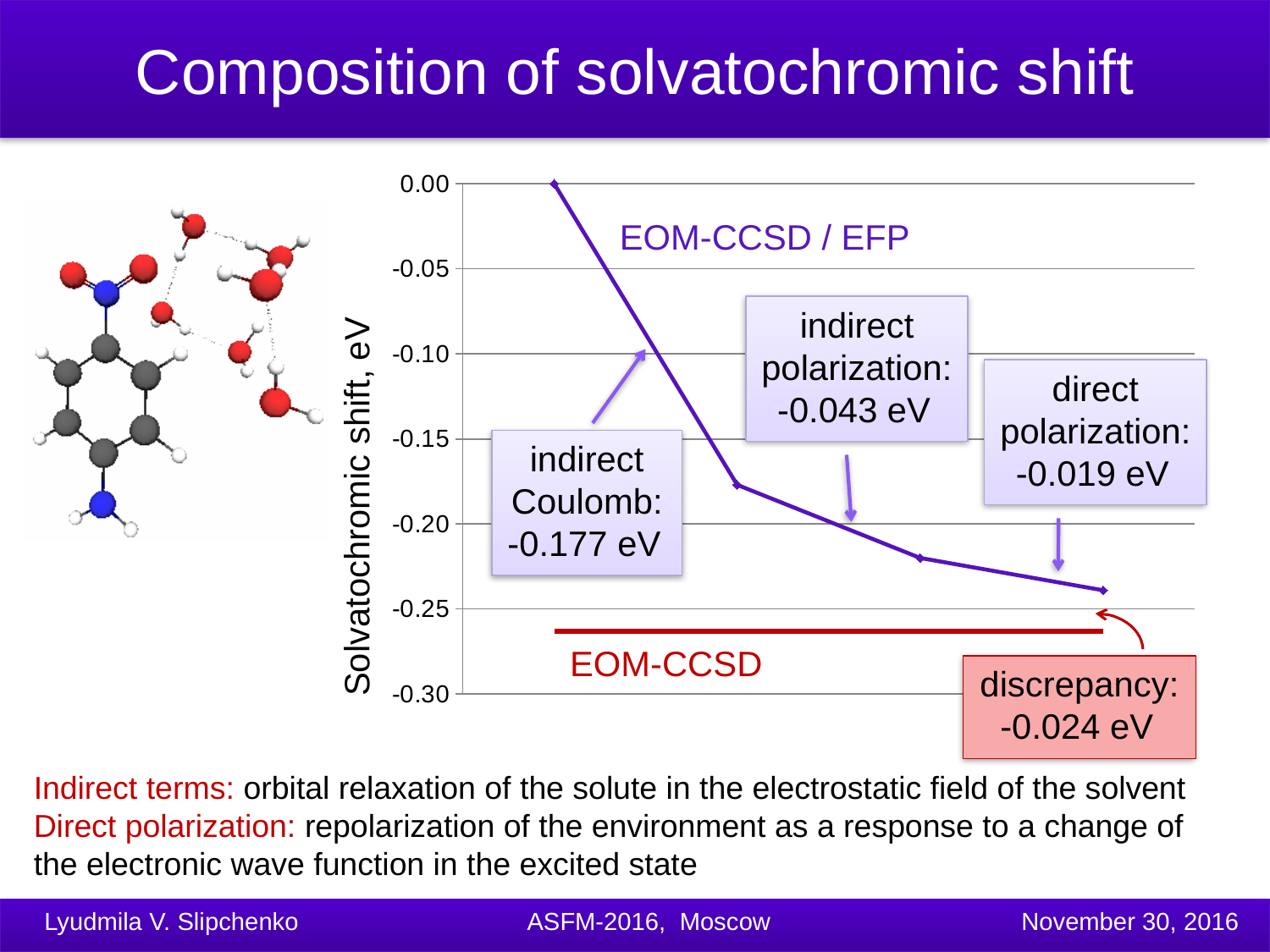
What is the label of the y axis of the chart? Solvatochromic shift, eV By how much does the magnitude of the indirect polarization contribution exceed that of the direct polarization contribution? 0.024 eV What kind of chart is shown on the slide? line chart What is the value of the direct polarization contribution shown on the chart? -0.019 eV Does the EOM-CCSD/EFP line rise or fall from left to right? fall What is the sum of the indirect Coulomb, indirect polarization and direct polarization contributions? -0.239 eV What is the discrepancy between EOM-CCSD/EFP and EOM-CCSD shown on the chart? -0.024 eV Is the value of the red EOM-CCSD line greater or less than -0.25? less What is the value of the indirect Coulomb contribution shown on the chart? -0.177 eV What is the value of the indirect polarization contribution shown on the chart? -0.043 eV Which of the three labelled contributions has the smallest magnitude? direct polarization Which contribution has the larger magnitude, indirect Coulomb or indirect polarization? indirect Coulomb